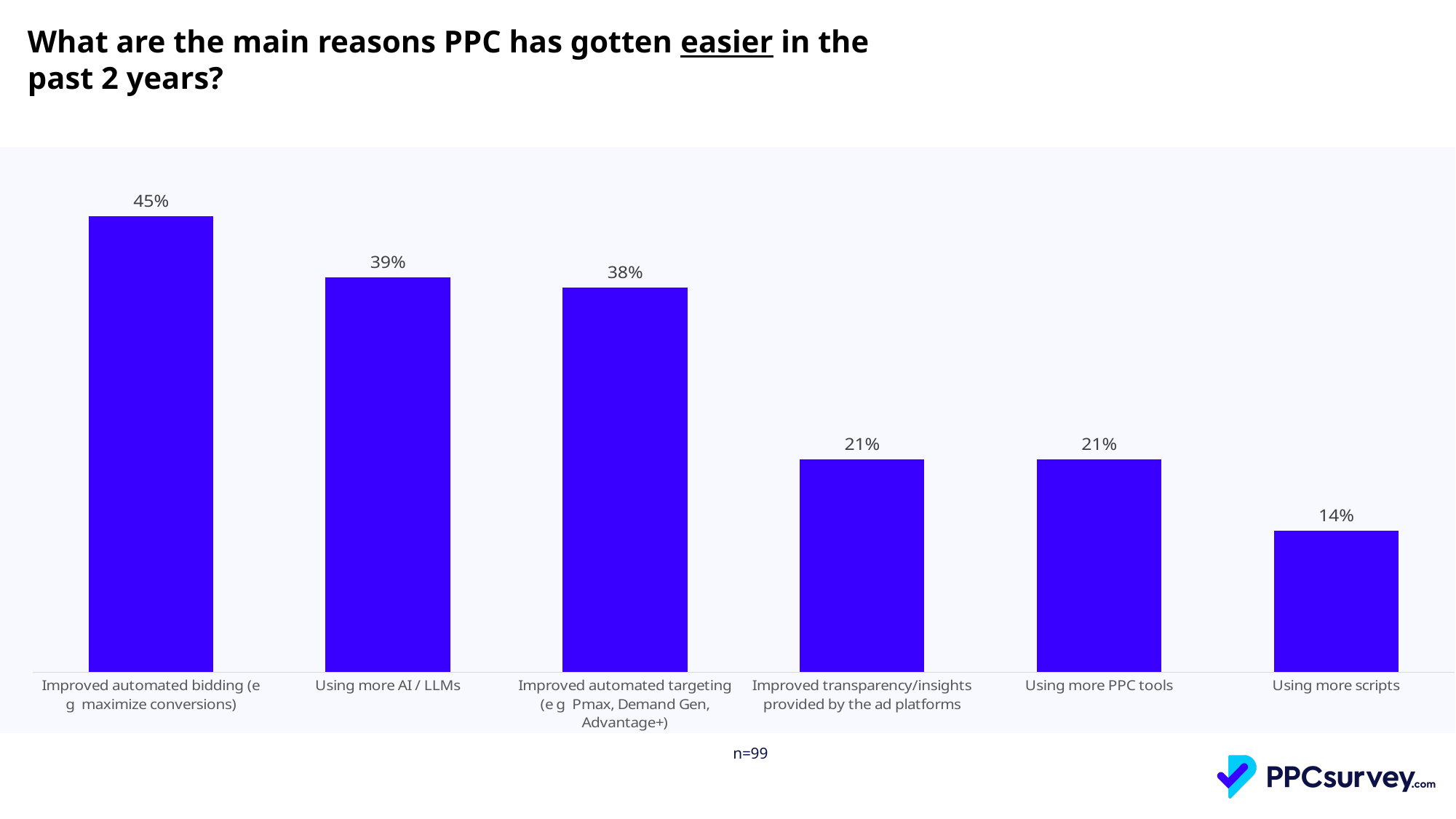
Which reason has the highest percentage? Improved automated bidding (e g maximize conversions) What is the value for 'Using more AI / LLMs'? 39% What is the value for 'Improved transparency/insights provided by the ad platforms'? 21% What is the difference between the values for 'Using more AI / LLMs' and 'Improved automated targeting'? 1% What is the value for 'Using more scripts'? 14% What is the difference between the values for improved automated bidding and using more scripts? 31% Which reason has the lowest percentage? Using more scripts What is the sample size (n) noted below the chart? n=99 Which is larger: the value for 'Using more PPC tools' or the value for 'Using more scripts'? Using more PPC tools What kind of chart is shown on the slide? Bar chart How many reasons (categories) are shown in the chart? 6 What percentage of respondents cited improved automated bidding as a reason PPC has gotten easier? 45%